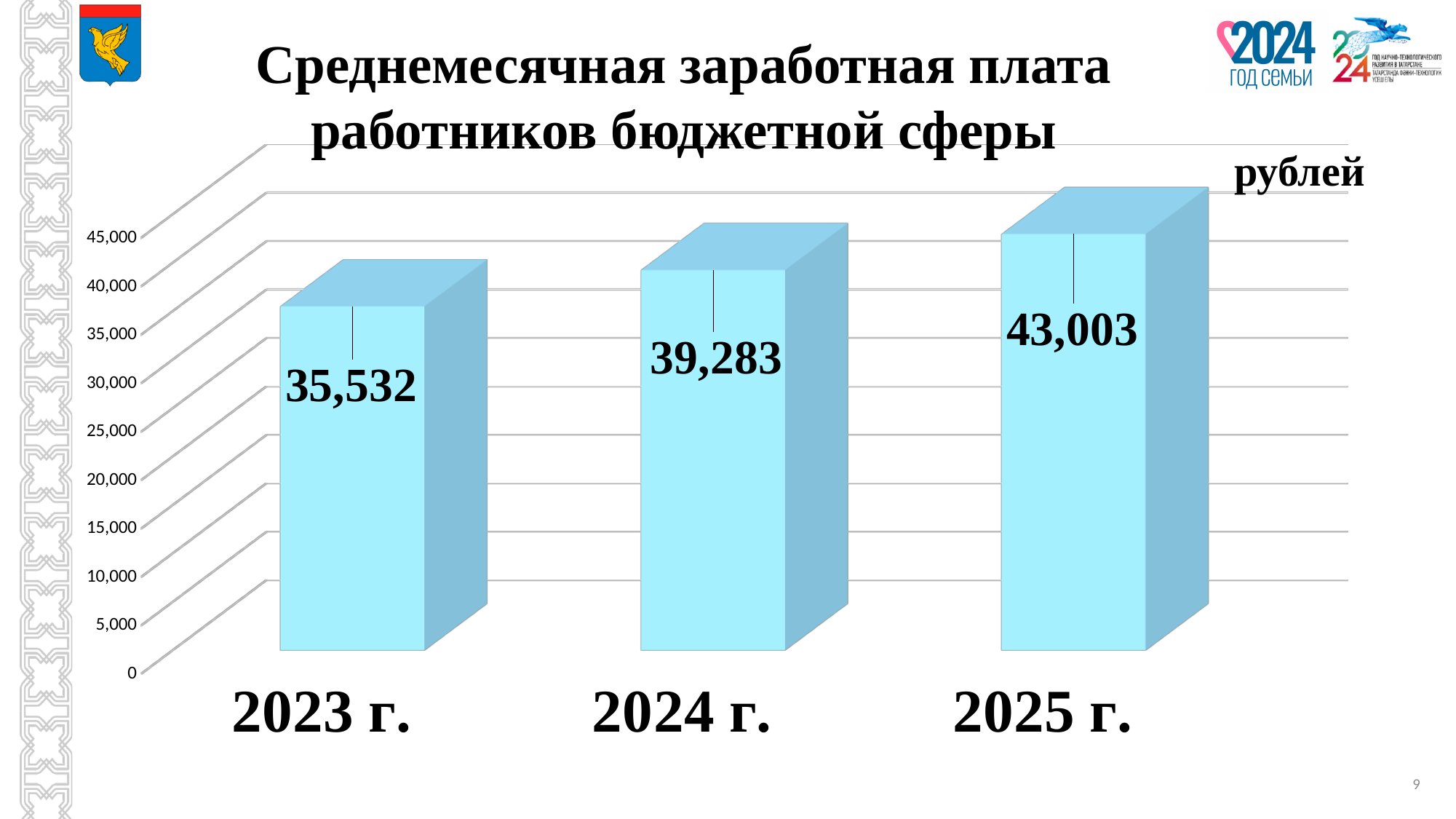
What kind of chart is shown on the slide? bar chart What is the value for 2025 г.? 43,003 Do the values rise or fall from 2023 г. to 2025 г.? rise How many years are shown on the chart? 3 What is the difference between the values for 2024 г. and 2023 г.? 3,751 Is the value for 2025 г. greater or less than 40,000? greater Which year has the highest value? 2025 г. What is the difference between the values for 2025 г. and 2023 г.? 7,471 Which year has the lowest value? 2023 г. What is the value for 2023 г.? 35,532 Which is larger, the value for 2024 г. or the value for 2025 г.? 2025 г. What is the value for 2024 г.? 39,283